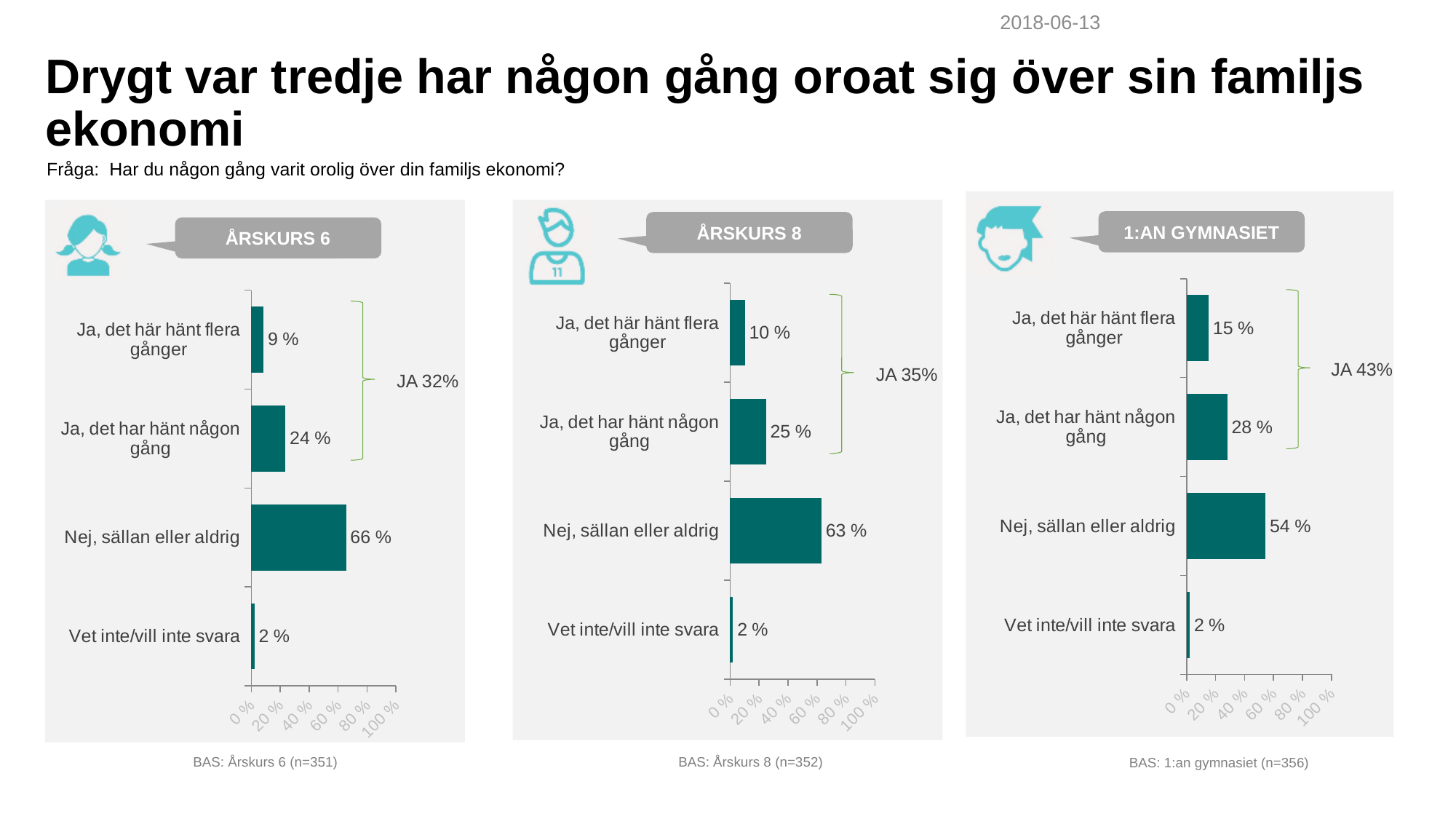
How many categories does the ÅRSKURS 6 chart show? 4 What combined "JA" share is annotated on the 1:AN GYMNASIET chart? JA 43% In the 1:AN GYMNASIET chart, what is the value for "Ja, det här hänt flera gånger"? 15 % In the ÅRSKURS 8 chart, what is the difference between "Nej, sällan eller aldrig" and "Ja, det har hänt någon gång"? 38 % In the ÅRSKURS 6 chart, which category has the lowest value? Vet inte/vill inte svara In the ÅRSKURS 6 chart, what is the value for "Nej, sällan eller aldrig"? 66 % What kind of chart is the ÅRSKURS 8 chart? bar chart In the 1:AN GYMNASIET chart, what is the difference between "Ja, det har hänt någon gång" and "Ja, det här hänt flera gånger"? 13 % In the 1:AN GYMNASIET chart, which category has the highest value? Nej, sällan eller aldrig In the ÅRSKURS 8 chart, is the value for "Nej, sällan eller aldrig" greater or less than 40 %? greater Which is larger: "Nej, sällan eller aldrig" in the ÅRSKURS 6 chart or in the 1:AN GYMNASIET chart? ÅRSKURS 6 In the ÅRSKURS 8 chart, what is the value for "Ja, det har hänt någon gång"? 25 %